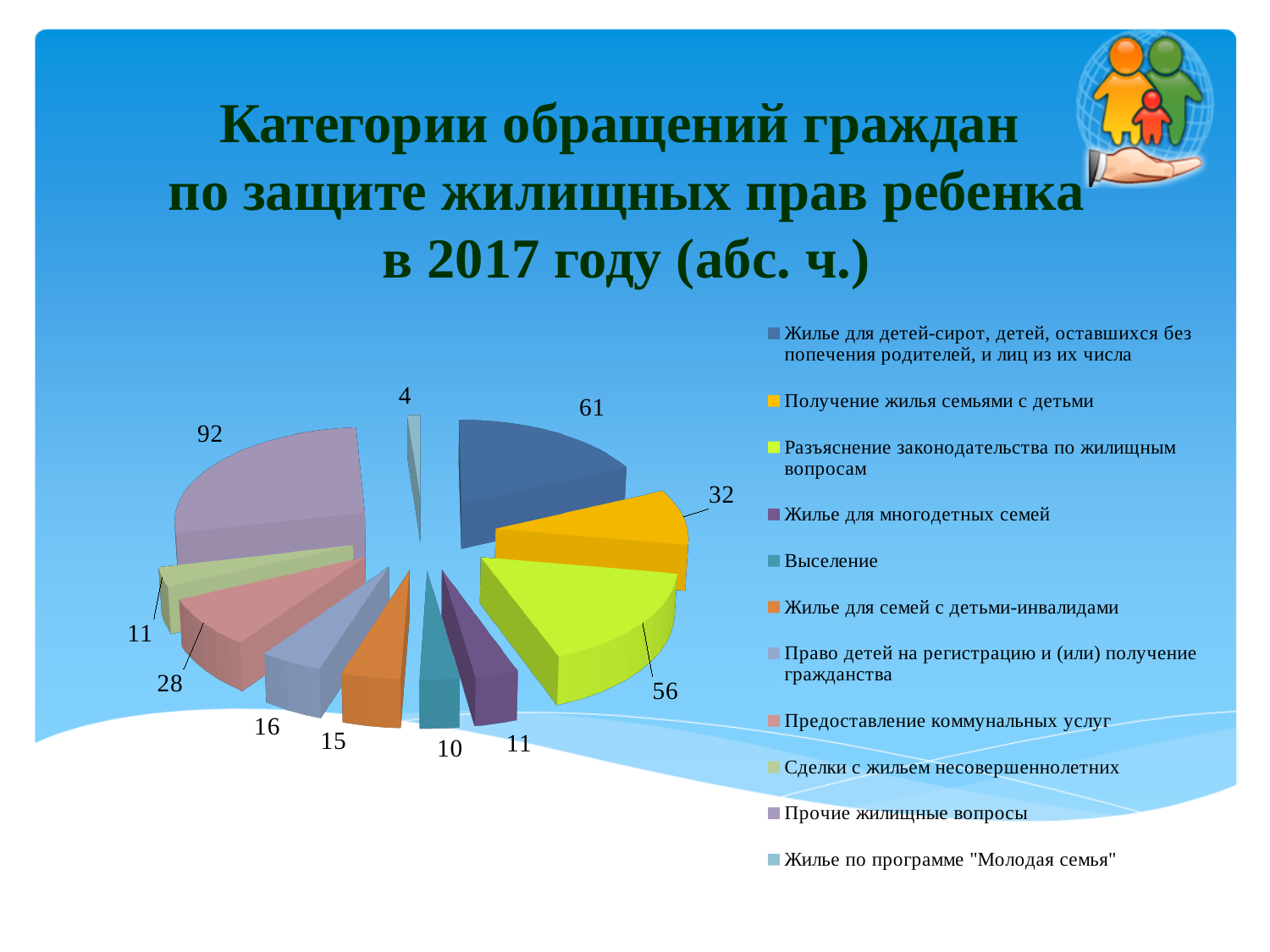
Which is larger: the value for "Получение жилья семьями с детьми" or the value for "Разъяснение законодательства по жилищным вопросам"? Разъяснение законодательства по жилищным вопросам What is the value for "Предоставление коммунальных услуг"? 28 Which category has the smallest slice of the pie? Жилье по программе "Молодая семья" What is the value for "Разъяснение законодательства по жилищным вопросам"? 56 What is the difference between the values for "Прочие жилищные вопросы" and "Жилье для детей-сирот, детей, оставшихся без попечения родителей, и лиц из их числа"? 31 What is the value for "Прочие жилищные вопросы"? 92 What is the value for "Жилье по программе "Молодая семья""? 4 What kind of chart is shown on the slide? Pie chart What is the title of the chart on the slide? Категории обращений граждан по защите жилищных прав ребенка в 2017 году (абс. ч.) What is the value for "Жилье для детей-сирот, детей, оставшихся без попечения родителей, и лиц из их числа"? 61 Which category has the largest slice of the pie? Прочие жилищные вопросы How many categories does the legend of the pie chart list? 11